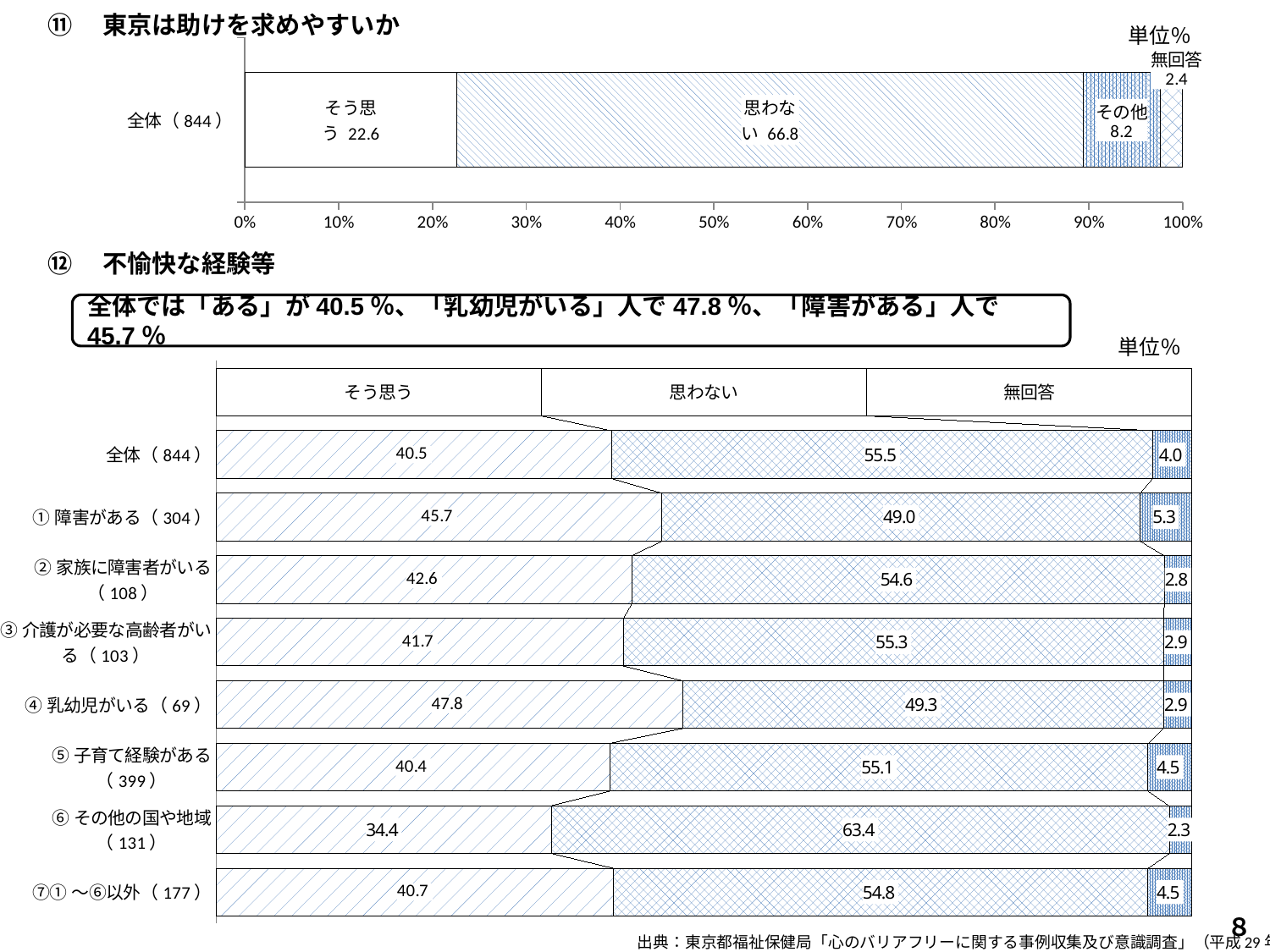
In the chart ⑫ 不愉快な経験等, what is the 無回答 value for ① 障害がある (304)? 5.3 In the chart ⑫ 不愉快な経験等, what is the 思わない value for ⑥ その他の国や地域 (131)? 63.4 What type of chart is the chart ⑫ 不愉快な経験等? Stacked bar chart In the chart ⑪ 東京は助けを求めやすいか, what is the value for 思わない? 66.8 In the chart ⑫ 不愉快な経験等, how many categories (rows) are shown? 8 In the chart ⑫ 不愉快な経験等, what is the difference between the そう思う values for ① 障害がある (304) and 全体 (844)? 5.2 In the chart ⑫ 不愉快な経験等, which category has the highest そう思う value? ④ 乳幼児がいる (69) In the chart ⑪ 東京は助けを求めやすいか, what is the value for その他? 8.2 In the chart ⑫ 不愉快な経験等, what is the そう思う value for ④ 乳幼児がいる (69)? 47.8 In the chart ⑫ 不愉快な経験等, which category has the lowest そう思う value? ⑥ その他の国や地域 (131) In the chart ⑪ 東京は助けを求めやすいか, what is the value for そう思う? 22.6 In the chart ⑪ 東京は助けを求めやすいか, how many segments make up the bar for 全体 (844)? 4